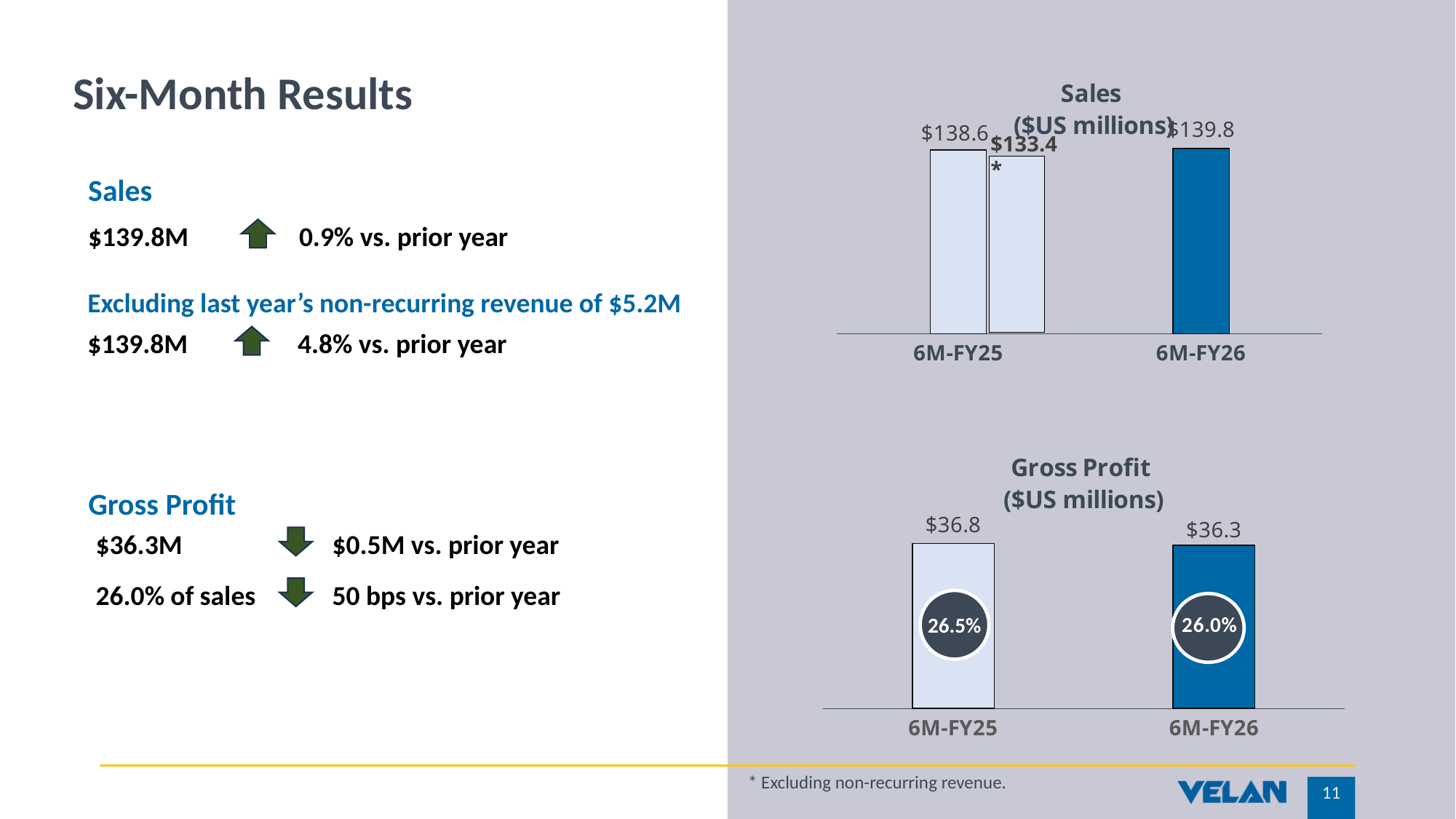
In the Sales chart, what is the 6M-FY25 value excluding non-recurring revenue (marked with an asterisk)? $133.4 In the Sales chart, what is the reported (first) value for 6M-FY25? $138.6 In the Sales chart, which period has the highest bar? 6M-FY26 What type of chart is the Gross Profit chart? Bar chart In the Sales chart, what is the value for 6M-FY26? $139.8 In the Gross Profit chart, what percentage is shown in the circle on the 6M-FY25 bar? 26.5% What does the asterisk next to $133.4 in the Sales chart indicate, according to the footnote? Excluding non-recurring revenue In the Gross Profit chart, what is the difference between the 6M-FY25 and 6M-FY26 values? $0.5 In the Sales chart, what is the difference between the 6M-FY26 value and the reported 6M-FY25 value of $138.6? $1.2 In the Gross Profit chart, which period has the lower gross profit? 6M-FY26 In the Gross Profit chart, what is the value for 6M-FY26? $36.3 In the Gross Profit chart, what is the value for 6M-FY25? $36.8